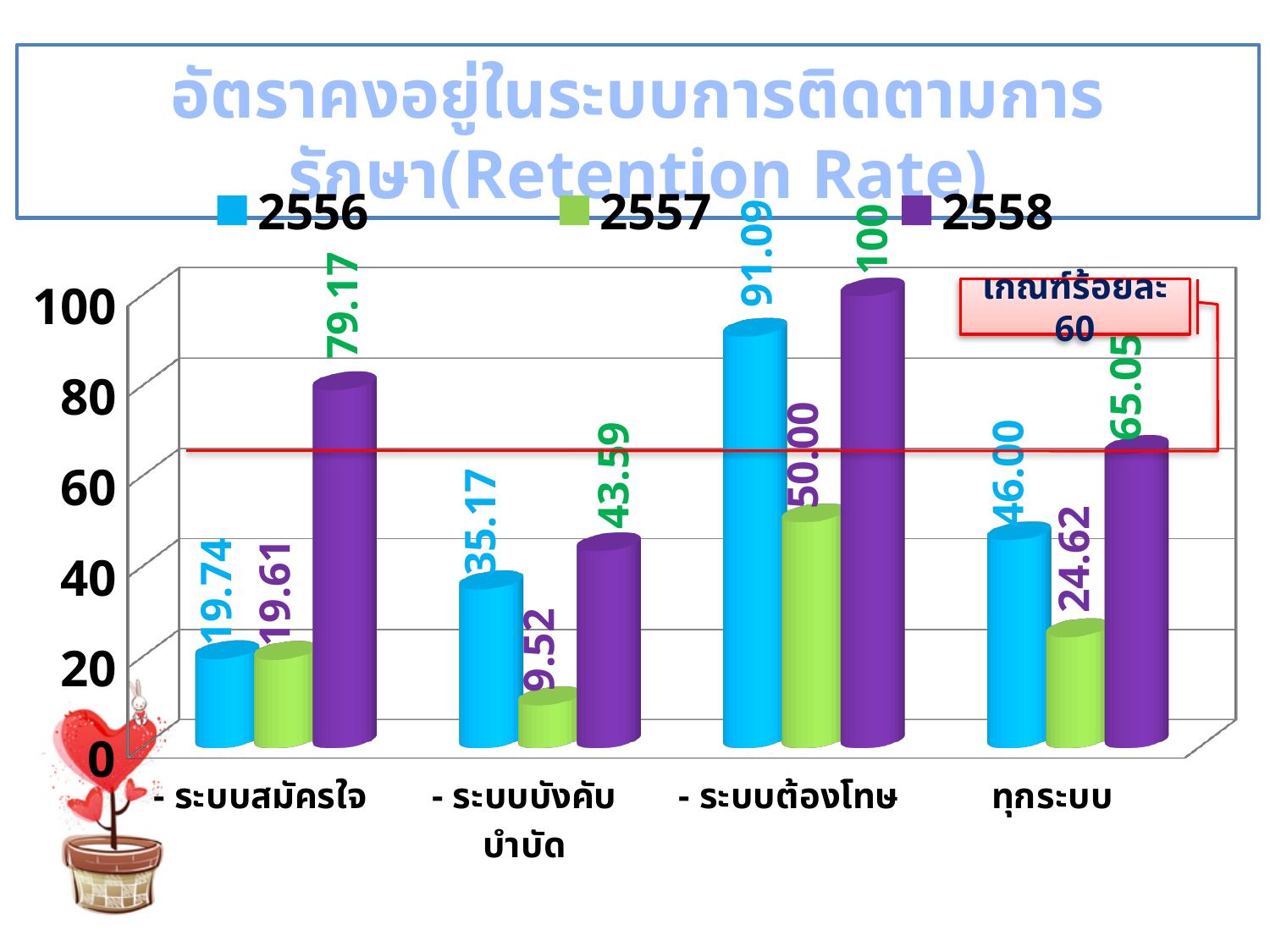
What is the value for 2558 in the ระบบสมัครใจ category? 79.17 Which category has the highest value for the 2558 series? ระบบต้องโทษ What is the value for 2557 in the ระบบบังคับบำบัด category? 9.52 Which category has the lowest value for the 2557 series? ระบบบังคับบำบัด What threshold value is indicated by the red horizontal line label on the chart? เกณฑ์ร้อยละ 60 What is the value for 2556 in the ระบบต้องโทษ category? 91.09 What kind of chart is shown on the slide? Bar chart Which is larger in the ระบบบังคับบำบัด category: the 2556 value or the 2558 value? 2558 What is the difference between the 2558 and 2556 values in the ทุกระบบ category? 19.05 How many categories are shown on the x axis? 4 What is the value for 2557 in the ทุกระบบ category? 24.62 How many series does the legend list? 3